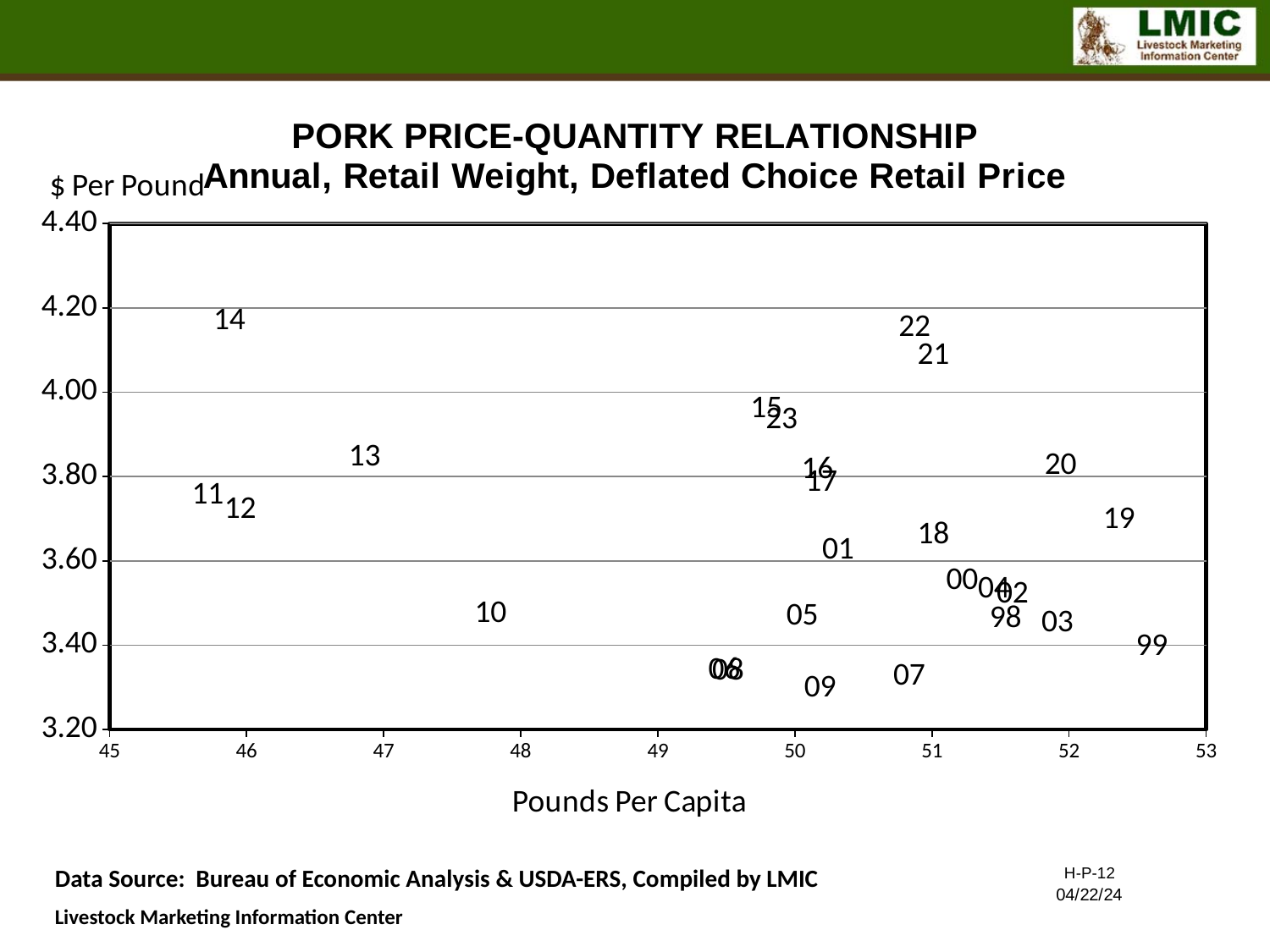
Is the price value for the point labelled 14 greater or less than 4.00? greater Is the price value for the point labelled 21 greater or less than 4.00? greater Which point has the higher price, 14 or 10? 14 Is the price value for the point labelled 19 greater or less than 3.80? less What kind of chart is shown on the slide? scatter chart What is the title of the chart? PORK PRICE-QUANTITY RELATIONSHIP Annual, Retail Weight, Deflated Choice Retail Price Which point has the higher price, 22 or 07? 22 Which point has the higher pounds per capita value, 99 or 11? 99 What is the label of the x axis? Pounds Per Capita